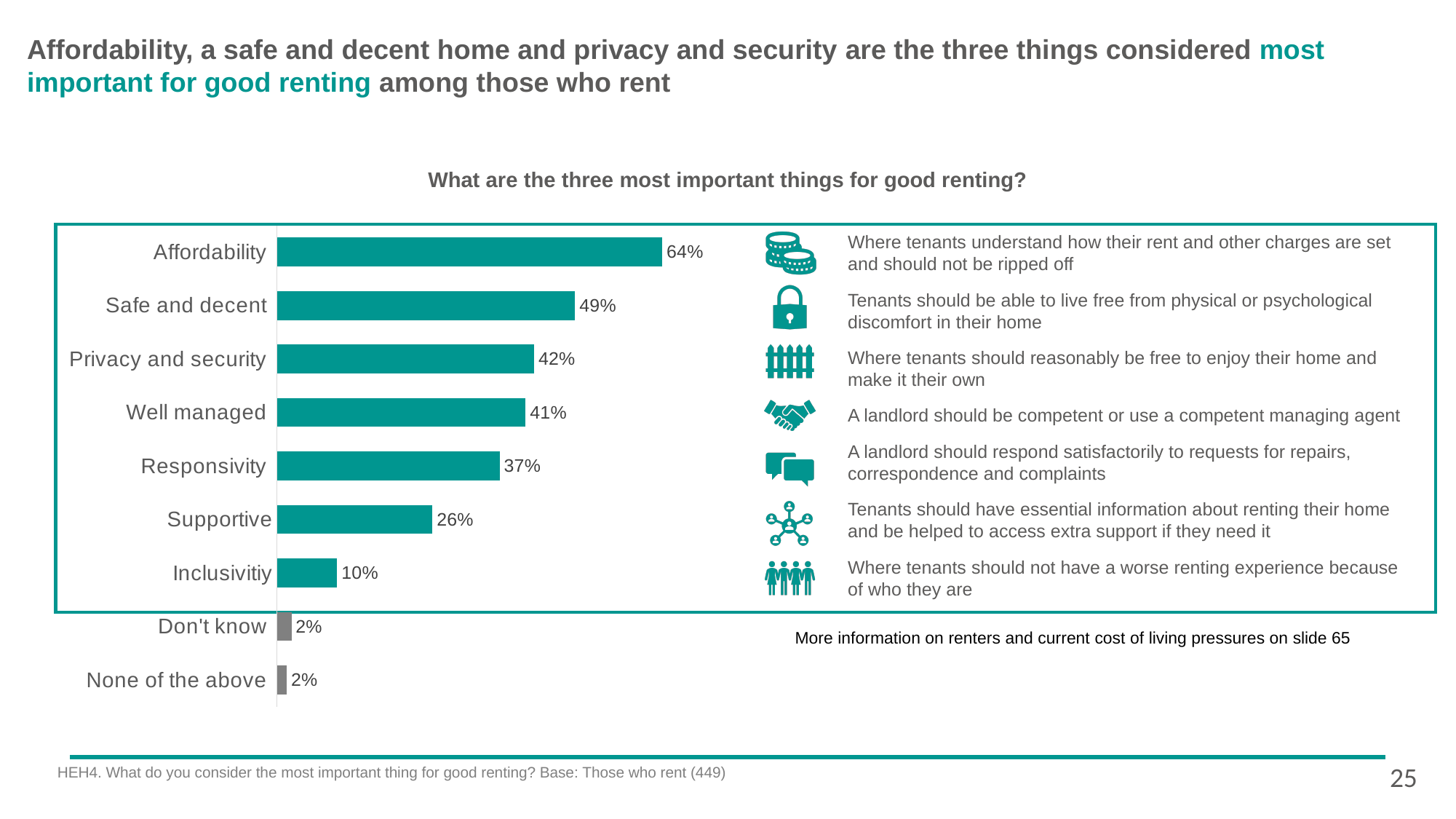
What is the difference in percentage points between Supportive and Inclusivitiy? 16 Which category has the highest value in the chart? Affordability What is the difference in percentage points between Affordability and Safe and decent? 15 How many categories are shown in the bar chart? 9 What percentage is shown for Responsivity? 37% Which category has the lowest value among the teal bars? Inclusivitiy What percentage of renters chose Affordability as one of the three most important things for good renting? 64% What is the value for Inclusivitiy? 10% What type of chart is shown on the slide? Bar chart What is the title of the chart? What are the three most important things for good renting? Which is larger, the value for Privacy and security or the value for Supportive? Privacy and security What is the value shown for Safe and decent? 49%